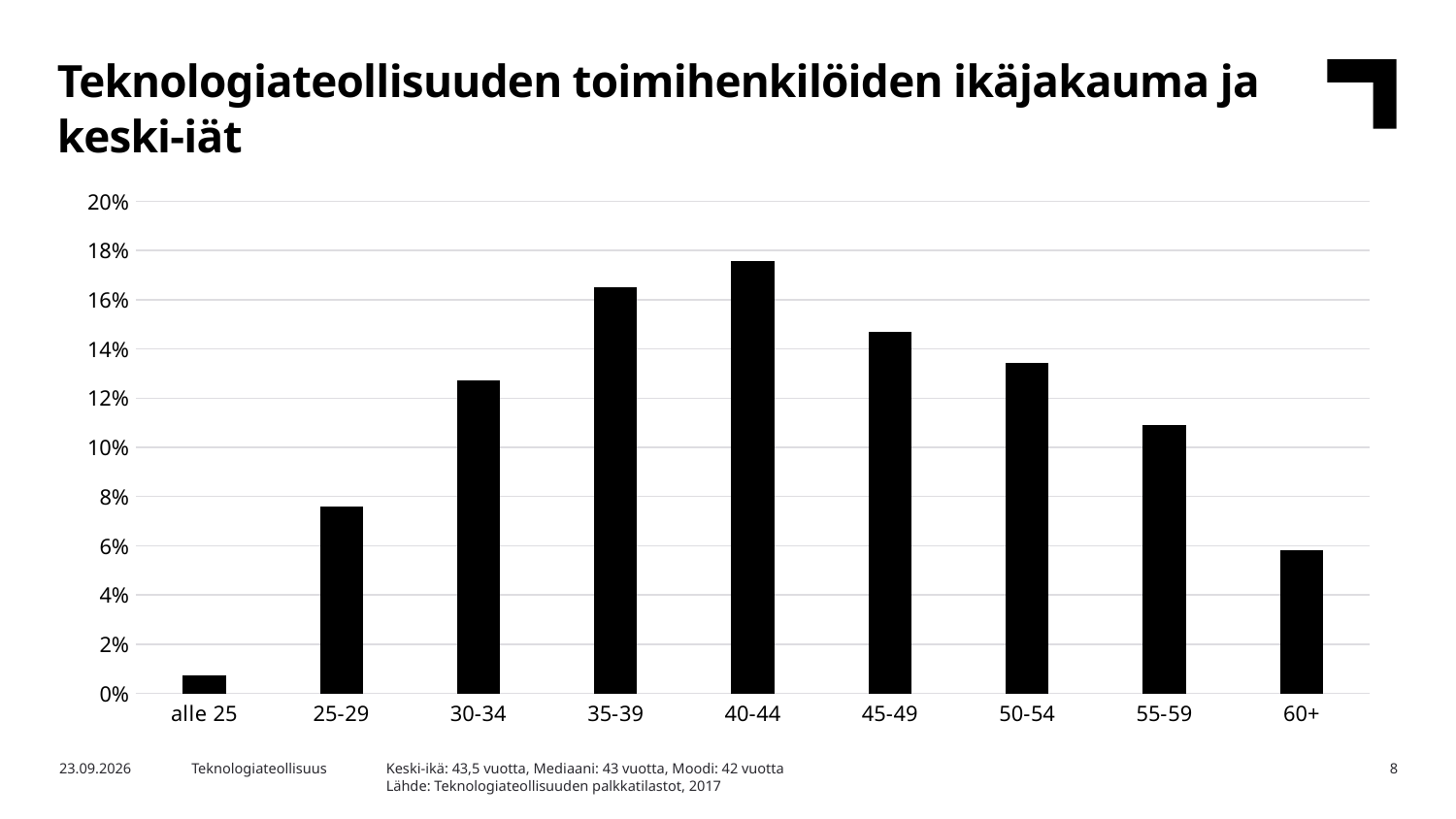
Do the values rise or fall from 40-44 to 60+ along the x axis? fall How many age categories are shown on the x axis? 9 Is the value for 55-59 greater or less than 12%? less What kind of chart is shown on the slide? bar chart Is the value for 60+ greater or less than 4%? greater Which age category has the highest value? 40-44 What is the title of the chart on the slide? Teknologiateollisuuden toimihenkilöiden ikäjakauma ja keski-iät Is the value for 40-44 greater or less than 16%? greater Which is larger, the value for 30-34 or the value for 45-49? 45-49 Which is larger, the value for 35-39 or the value for 50-54? 35-39 Which age category has the lowest value? alle 25